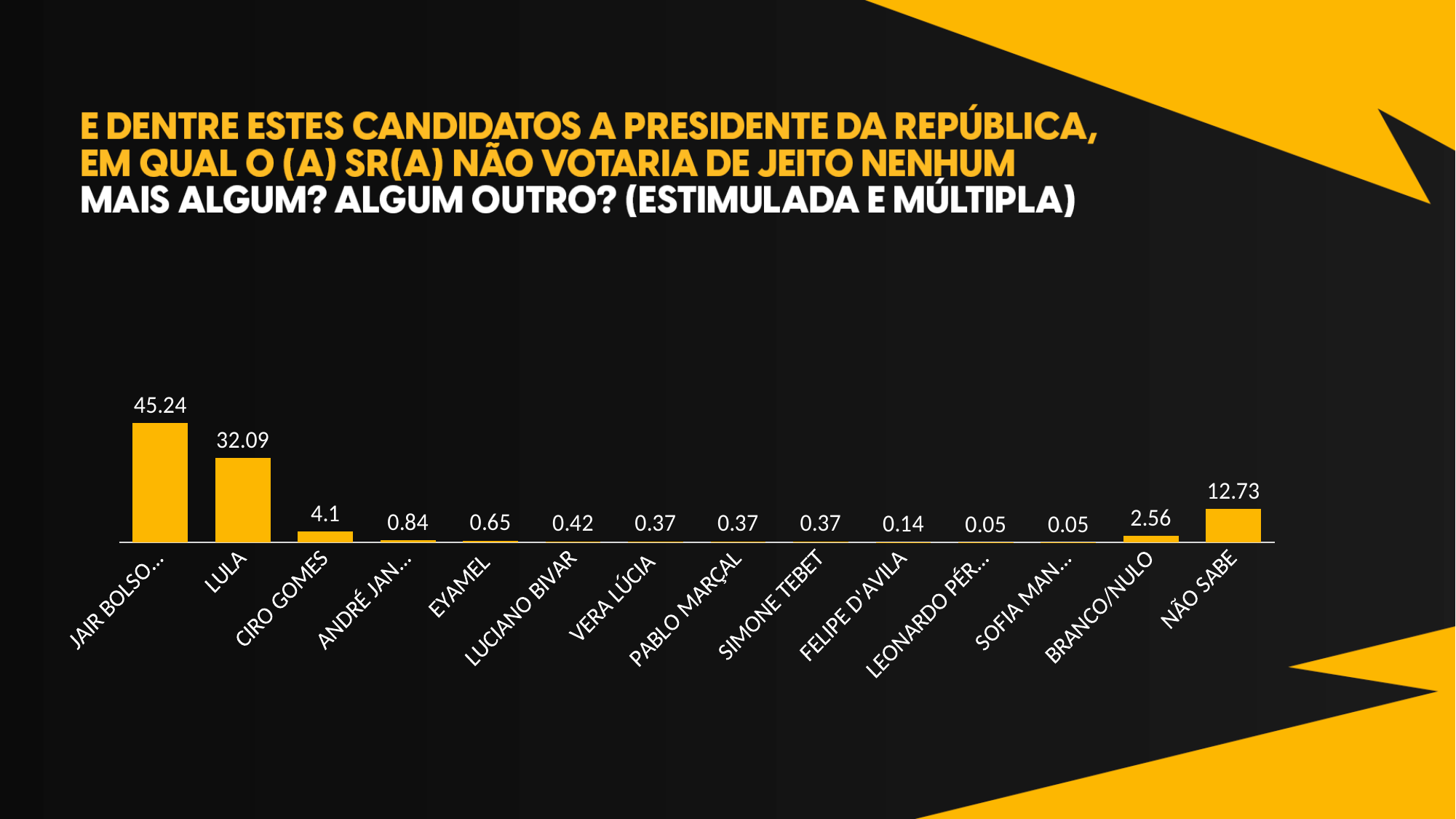
How many categories are shown on the x axis of the chart? 14 What is the difference between the values for LULA and NÃO SABE? 19.36 What is the value for SIMONE TEBET? 0.37 What is the value for FELIPE D'AVILA? 0.14 Which is larger, the value for CIRO GOMES or the value for BRANCO/NULO? CIRO GOMES What is the value for CIRO GOMES? 4.1 What is the value for EYAMEL? 0.65 What kind of chart is shown on the slide? Bar chart What is the value for LULA? 32.09 What is the value for BRANCO/NULO? 2.56 What is the difference between the values for NÃO SABE and CIRO GOMES? 8.63 What is the value for NÃO SABE? 12.73